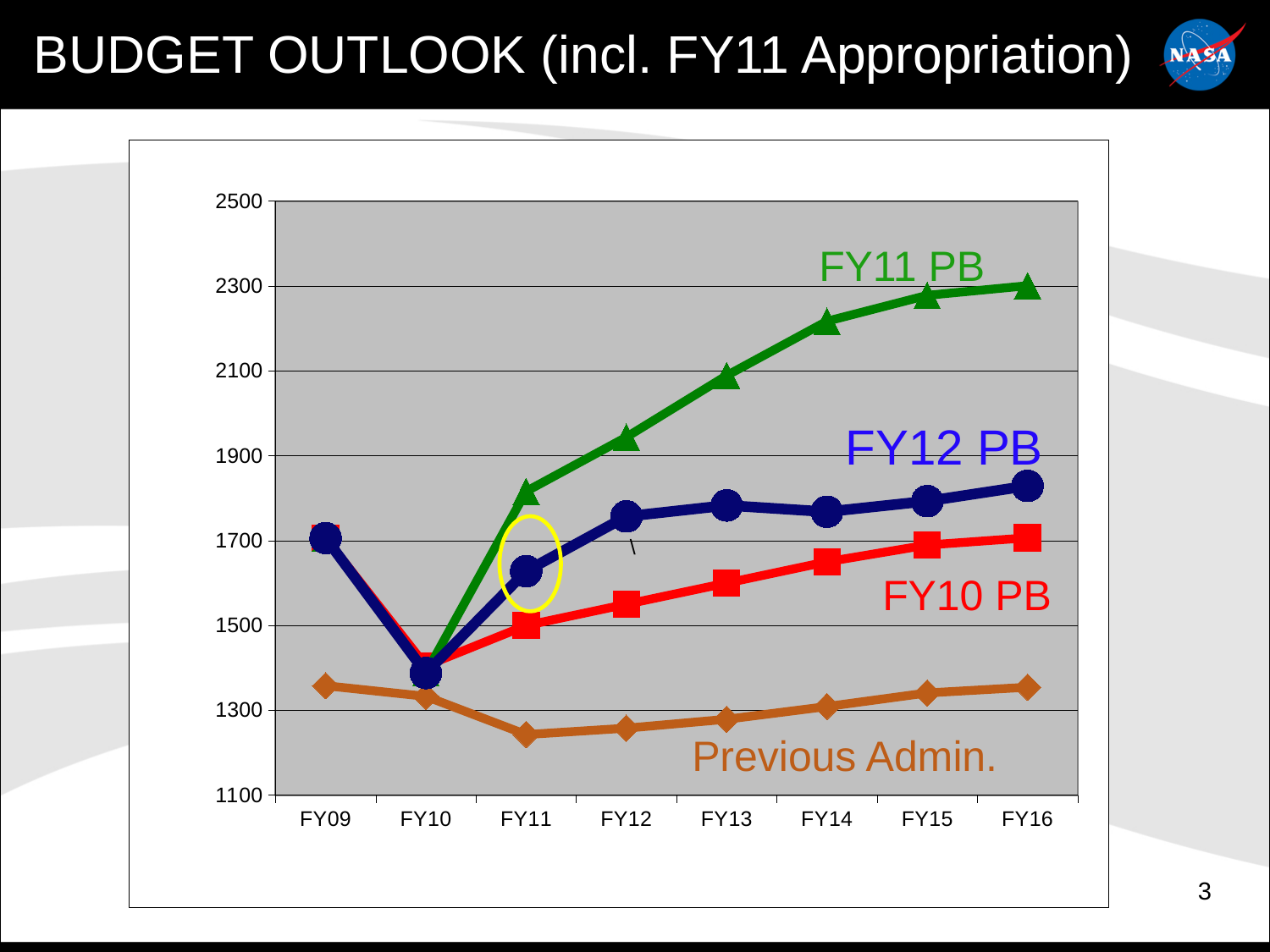
What is the title of the slide? BUDGET OUTLOOK (incl. FY11 Appropriation) Is the FY11 PB value at FY16 greater or less than 2100? greater Which series has the highest value at FY16? FY11 PB What kind of chart is shown on the slide? line chart Which series has the lowest value at FY16? Previous Admin. In which fiscal year does the FY12 PB series reach its lowest value? FY10 How many data series are plotted on the chart? 4 How many fiscal years are shown along the x axis? 8 At FY13, which is larger: the FY12 PB value or the FY10 PB value? FY12 PB Is the FY12 PB value at FY11 greater or less than 1500? greater Does the FY11 PB series rise or fall from FY10 to FY16? rise Is the Previous Admin. value at FY11 greater or less than 1300? less